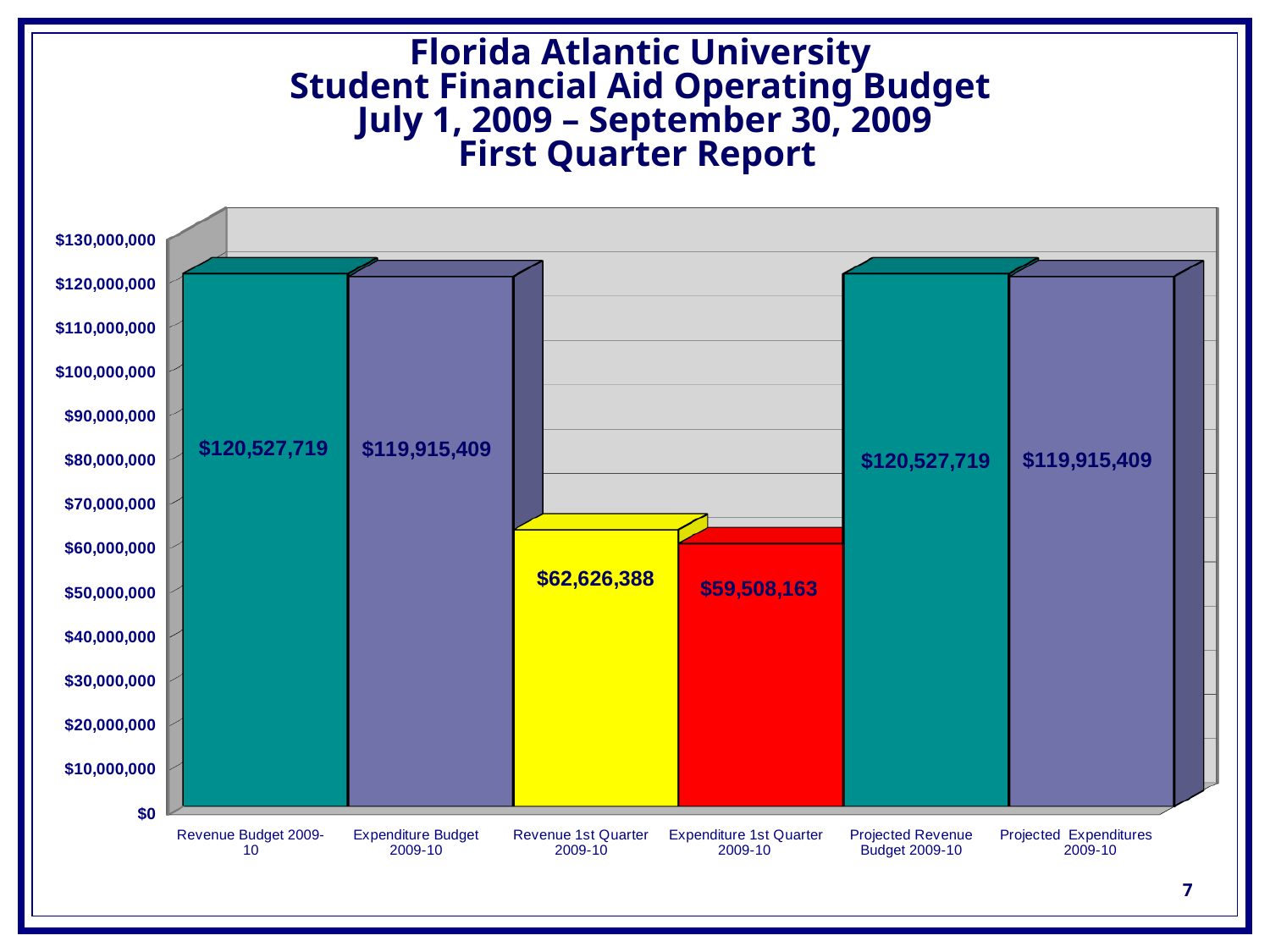
What is the value for Revenue 1st Quarter 2009-10? $62,626,388 Which category has the lowest value? Expenditure 1st Quarter 2009-10 What is the difference between Revenue Budget 2009-10 and Expenditure Budget 2009-10? $612,310 What is the value for Revenue Budget 2009-10? $120,527,719 What kind of chart is shown on the slide? bar chart Which is larger, Revenue 1st Quarter 2009-10 or Expenditure 1st Quarter 2009-10? Revenue 1st Quarter 2009-10 Is the value for Revenue 1st Quarter 2009-10 greater or less than $70,000,000? less What is the value for Expenditure Budget 2009-10? $119,915,409 What is the difference between Revenue 1st Quarter 2009-10 and Expenditure 1st Quarter 2009-10? $3,118,225 What is the value for Projected Expenditures 2009-10? $119,915,409 What is the value for Expenditure 1st Quarter 2009-10? $59,508,163 How many categories are shown on the x axis? 6